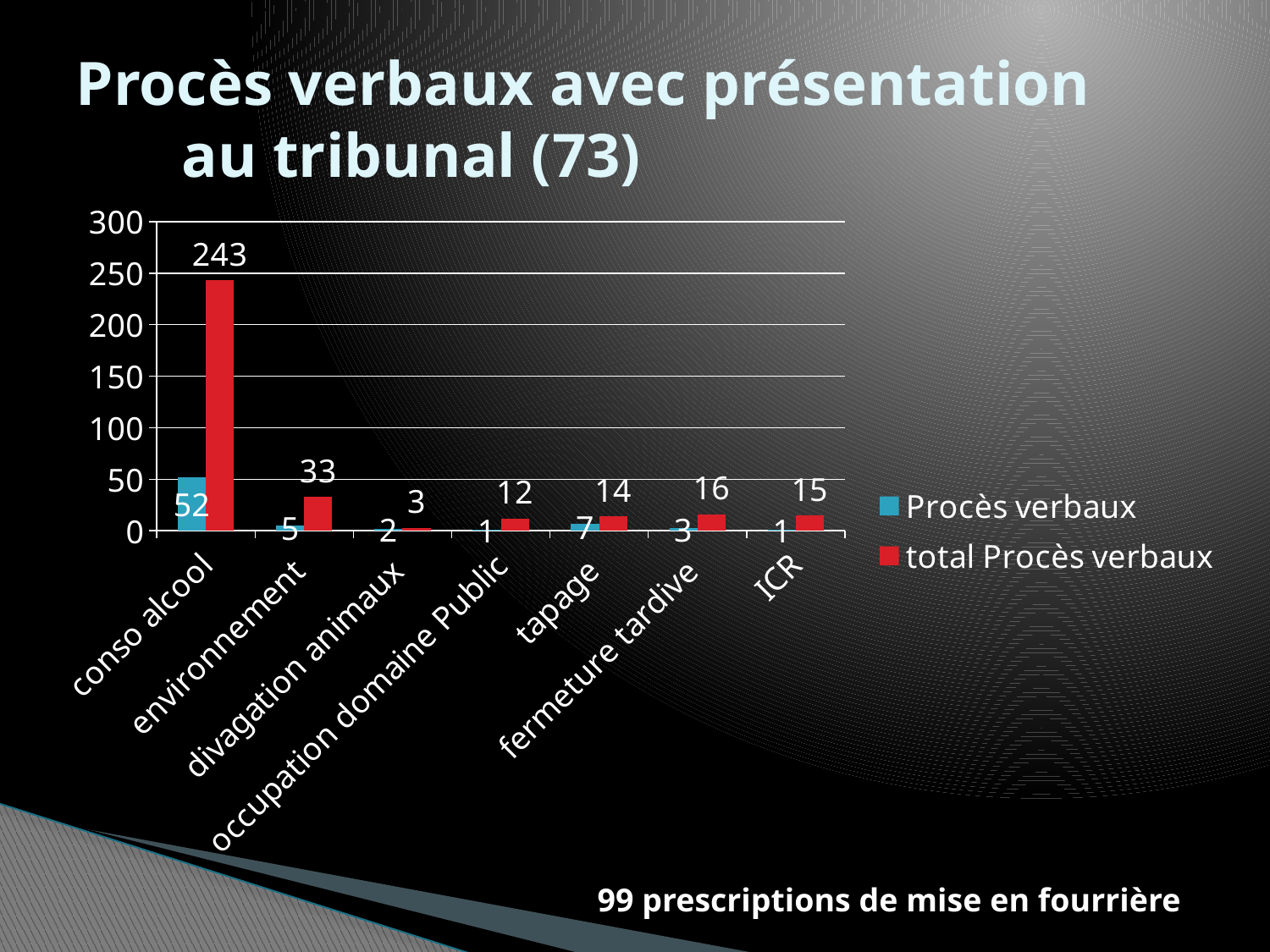
Which category has the lowest value for 'total Procès verbaux'? divagation animaux What is the value of 'total Procès verbaux' for environnement? 33 What is the value of 'Procès verbaux' for conso alcool? 52 Which category has the highest value for 'total Procès verbaux'? conso alcool What is the value of 'Procès verbaux' for tapage? 7 What is the difference between 'total Procès verbaux' and 'Procès verbaux' for conso alcool? 191 What is the title of the chart? Procès verbaux avec présentation au tribunal (73) What is the value of 'total Procès verbaux' for conso alcool? 243 How many series does the legend list? 2 What kind of chart is shown on the slide? bar chart How many categories are shown on the x axis? 7 Which is larger, the 'total Procès verbaux' value for fermeture tardive or for ICR? fermeture tardive